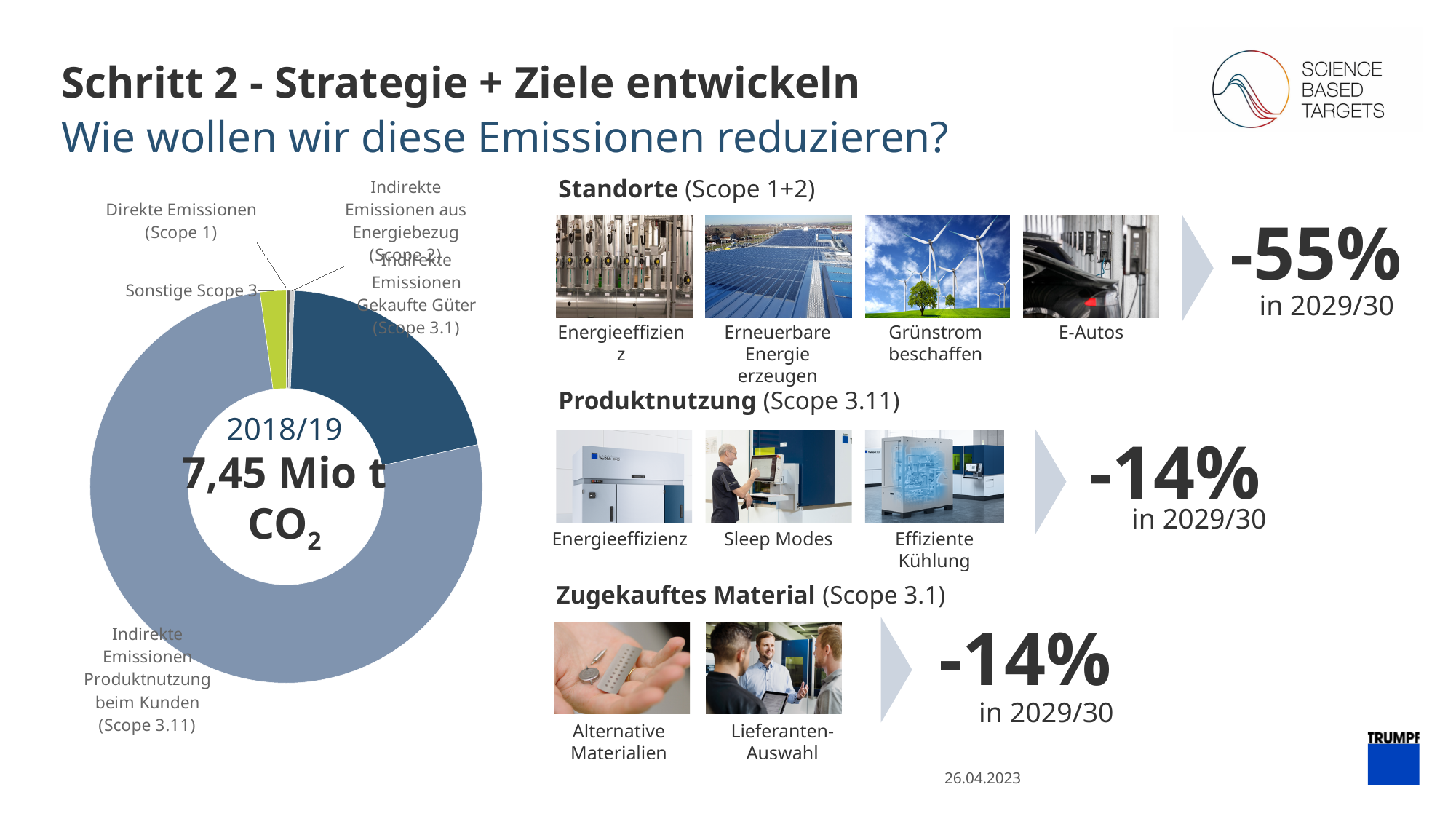
What kind of chart is shown on the left of the slide? Pie chart (donut) In the donut chart, which is larger: Sonstige Scope 3 or Indirekte Emissionen Gekaufte Güter (Scope 3.1)? Indirekte Emissionen Gekaufte Güter (Scope 3.1) Which category takes the largest share of the donut chart on the left? Indirekte Emissionen Produktnutzung beim Kunden (Scope 3.11) Which reporting year is shown in the centre of the donut chart? 2018/19 How many emission categories does the donut chart on the left break down? 5 In the donut chart, which is larger: Sonstige Scope 3 or Direkte Emissionen (Scope 1)? Sonstige Scope 3 What total emissions value is printed in the centre of the donut chart? 7,45 Mio t CO2 In the donut chart, which is larger: Indirekte Emissionen Produktnutzung beim Kunden (Scope 3.11) or Indirekte Emissionen Gekaufte Güter (Scope 3.1)? Indirekte Emissionen Produktnutzung beim Kunden (Scope 3.11)